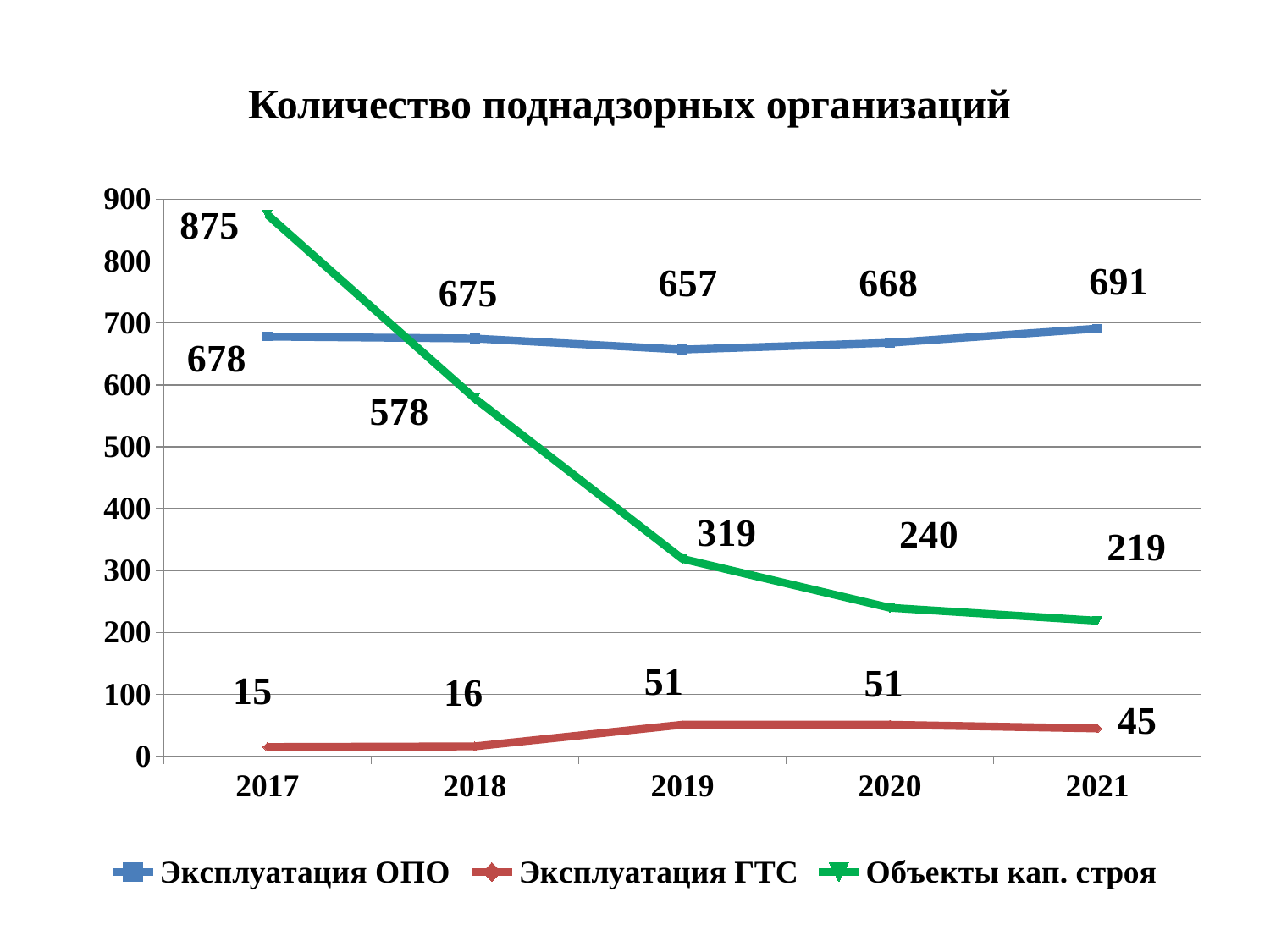
What is the title of the chart? Количество поднадзорных организаций In which year is the value for Объекты кап. строя lowest? 2021 How many series does the legend list? 3 In which year is the value for Эксплуатация ОПО highest? 2021 What is the value for Объекты кап. строя in 2017? 875 How many years are shown on the x axis? 5 What is the value for Эксплуатация ГТС in 2019? 51 What is the difference between the Объекты кап. строя values in 2017 and 2018? 297 Does the value for Объекты кап. строя rise or fall from 2017 to 2021? fall What type of chart is shown on the slide? line chart What is the value for Эксплуатация ОПО in 2021? 691 Which is larger in 2018: Эксплуатация ОПО or Объекты кап. строя? Эксплуатация ОПО